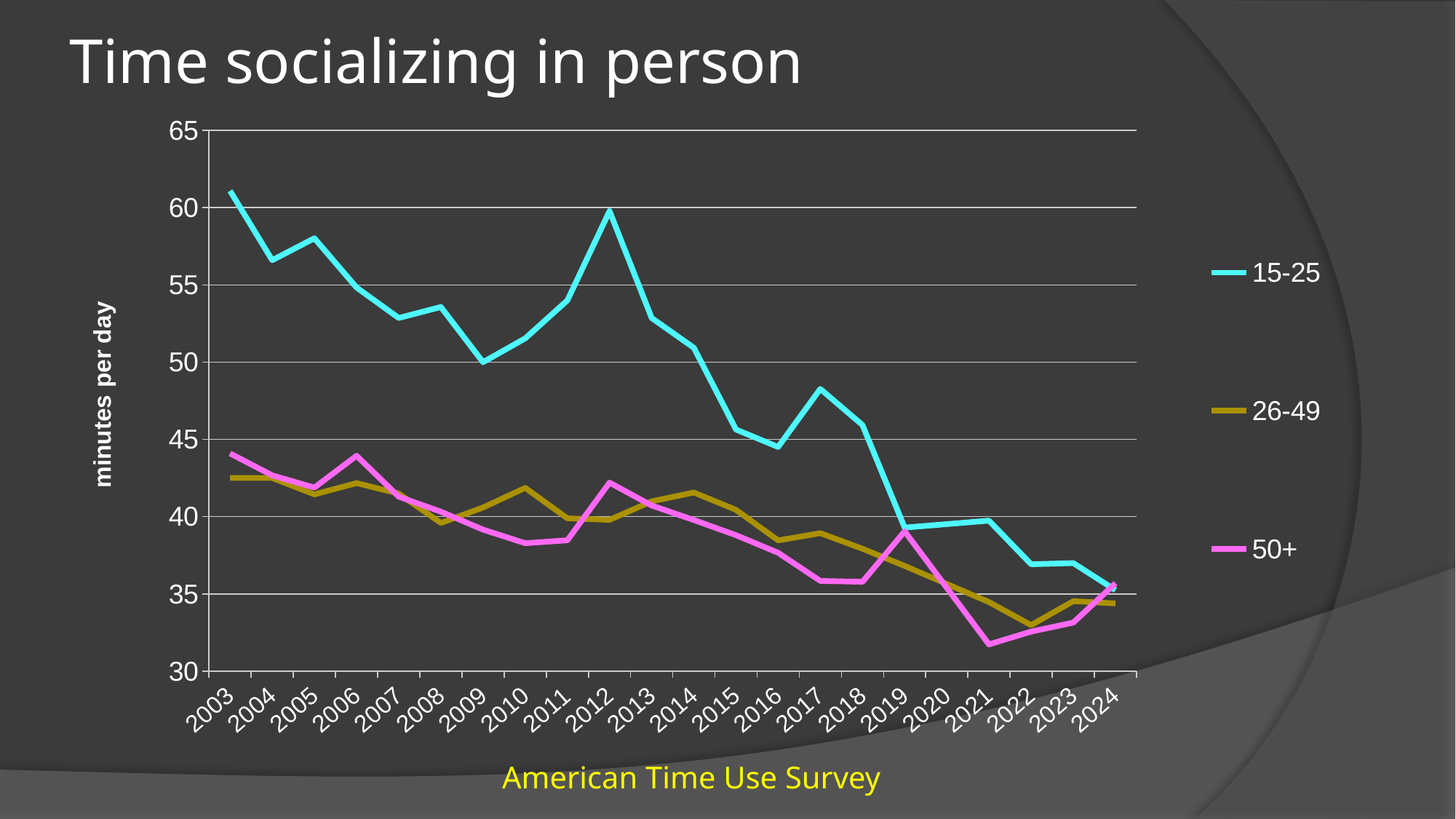
Which series has the highest value in 2010? 15-25 What kind of chart is shown on the slide? line chart Which is larger in 2017, the value for 26-49 or the value for 50+? 26-49 How many series does the legend list? 3 What is the label on the y axis? minutes per day Does the 15-25 line generally rise or fall from 2003 to 2024? fall How many years are labelled on the x axis? 22 Is the value for 50+ in 2021 greater or less than 35? less Is the value for 26-49 in 2010 greater or less than 40? greater In which year does the 50+ line reach its lowest value? 2021 Is the value for 15-25 in 2016 greater or less than 45? less